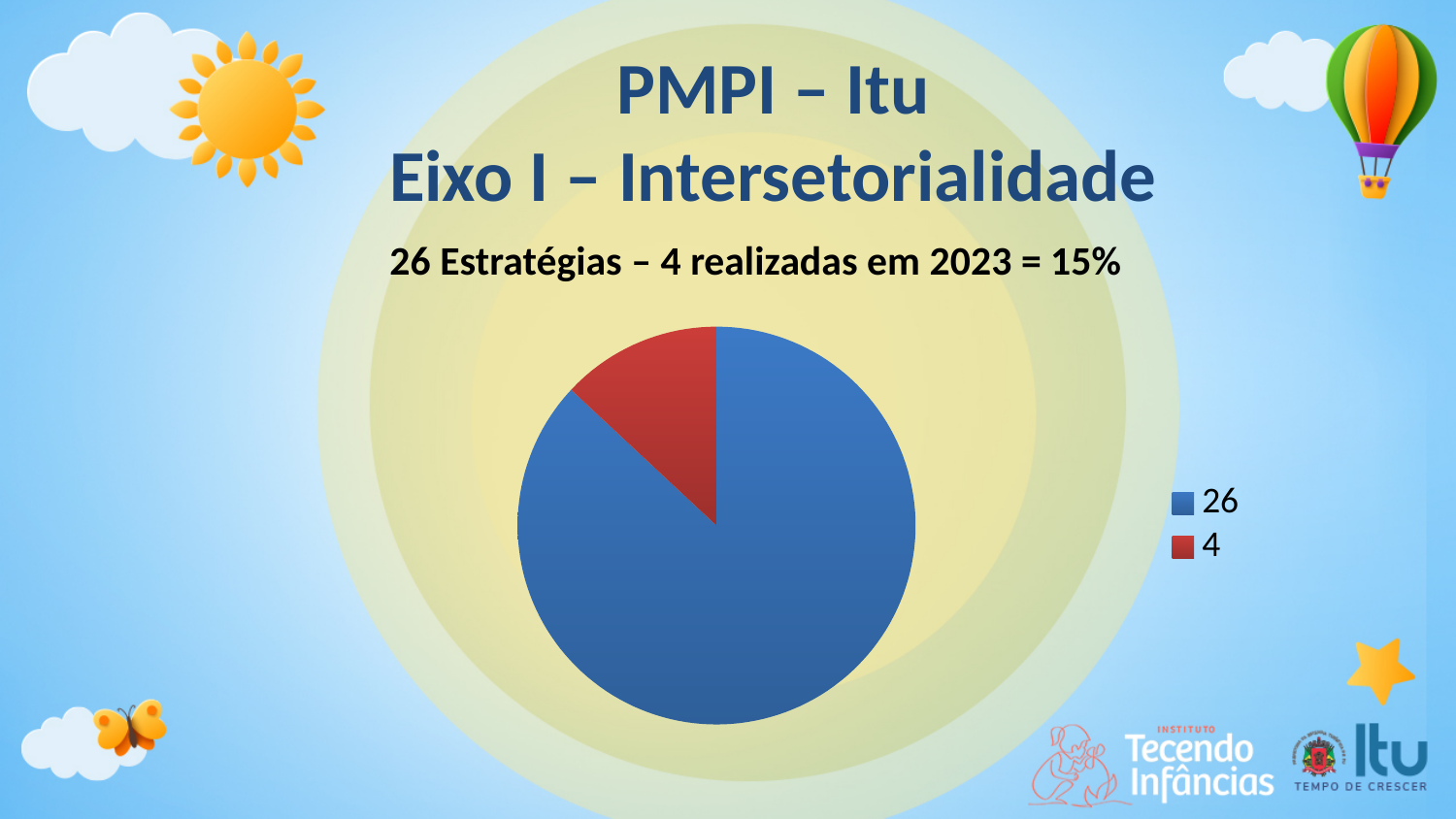
What colour is the slice labelled 26 in the legend? blue What is the difference between the two values shown in the legend, 26 and 4? 22 Which slice is larger, the blue one or the red one? the blue one What kind of chart is shown on the slide? pie chart How many entries does the legend of the pie chart list? 2 According to the slide, how many strategies were realized (realizadas) in 2023? 4 What colour is the slice labelled 4 in the legend? red According to the slide, how many strategies (Estratégias) are there in total for Eixo I? 26 Which legend entry corresponds to the largest slice of the pie chart? 26 What percentage of the strategies does the slide state were realized in 2023? 15% Which legend entry corresponds to the smallest slice of the pie chart? 4 How many slices does the pie chart have? 2